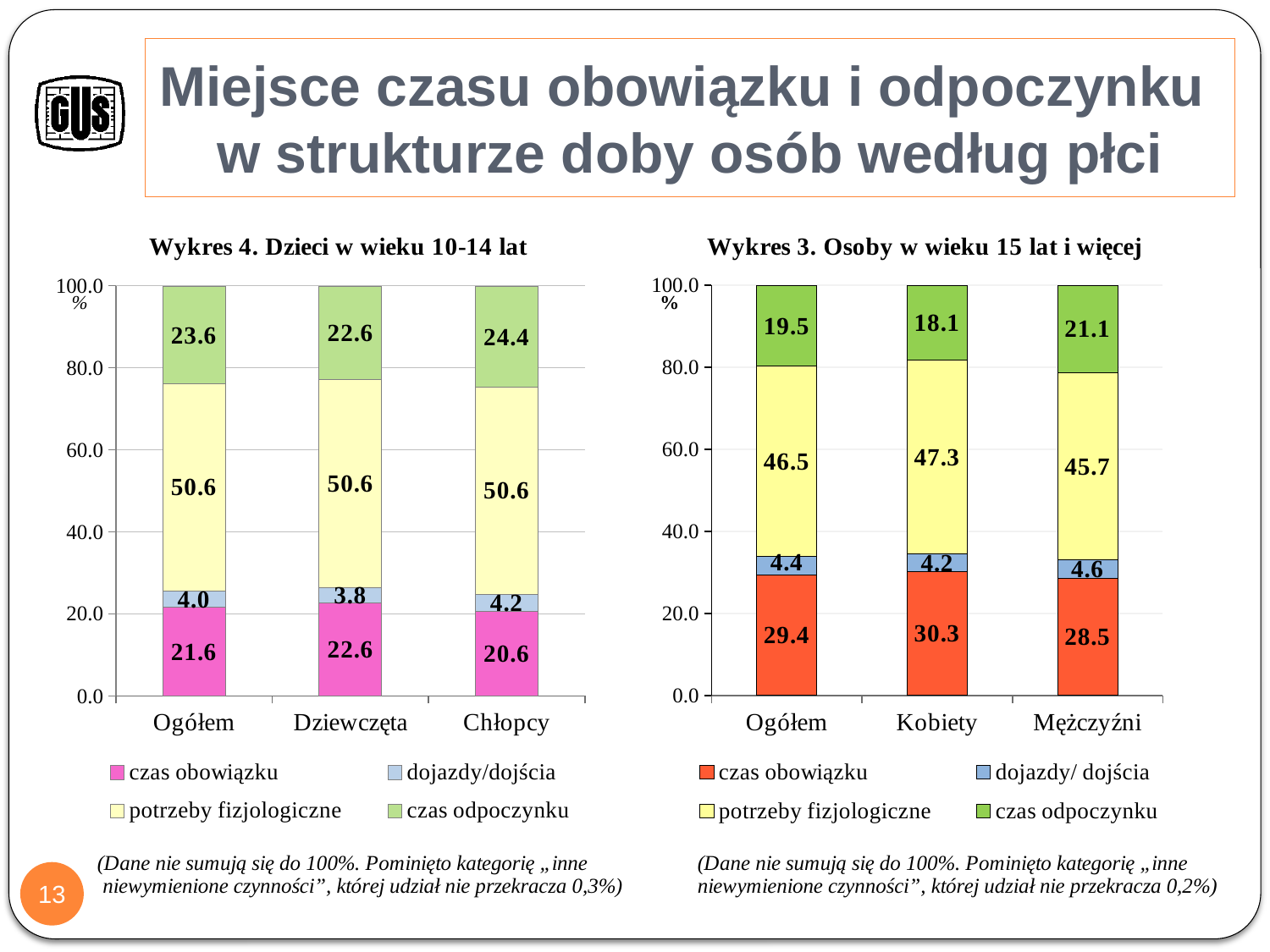
In the chart 'Wykres 4. Dzieci w wieku 10-14 lat', what is the value of 'czas obowiązku' for Dziewczęta? 22.6 In the chart 'Wykres 3. Osoby w wieku 15 lat i więcej', is the 'czas obowiązku' value for Ogółem greater or less than 20.0? greater In the chart 'Wykres 3. Osoby w wieku 15 lat i więcej', what is the difference between the 'potrzeby fizjologiczne' values for Kobiety and Mężczyźni? 1.6 What kind of chart is 'Wykres 4. Dzieci w wieku 10-14 lat'? stacked bar chart In the chart 'Wykres 4. Dzieci w wieku 10-14 lat', what is the value of 'dojazdy/dojścia' for Ogółem? 4.0 In the chart 'Wykres 3. Osoby w wieku 15 lat i więcej', what is the total of the four labelled segments for Kobiety? 99.9 How many categories are shown on the x axis of the chart 'Wykres 4. Dzieci w wieku 10-14 lat'? 3 In the chart 'Wykres 4. Dzieci w wieku 10-14 lat', which is larger: 'czas odpoczynku' for Chłopcy or for Dziewczęta? Chłopcy In the chart 'Wykres 3. Osoby w wieku 15 lat i więcej', what is the value of 'czas odpoczynku' for Mężczyźni? 21.1 In the chart 'Wykres 3. Osoby w wieku 15 lat i więcej', which category has the highest value for 'czas obowiązku'? Kobiety How many series does the legend of the chart 'Wykres 3. Osoby w wieku 15 lat i więcej' list? 4 In the chart 'Wykres 4. Dzieci w wieku 10-14 lat', which category has the lowest value for 'czas obowiązku'? Chłopcy